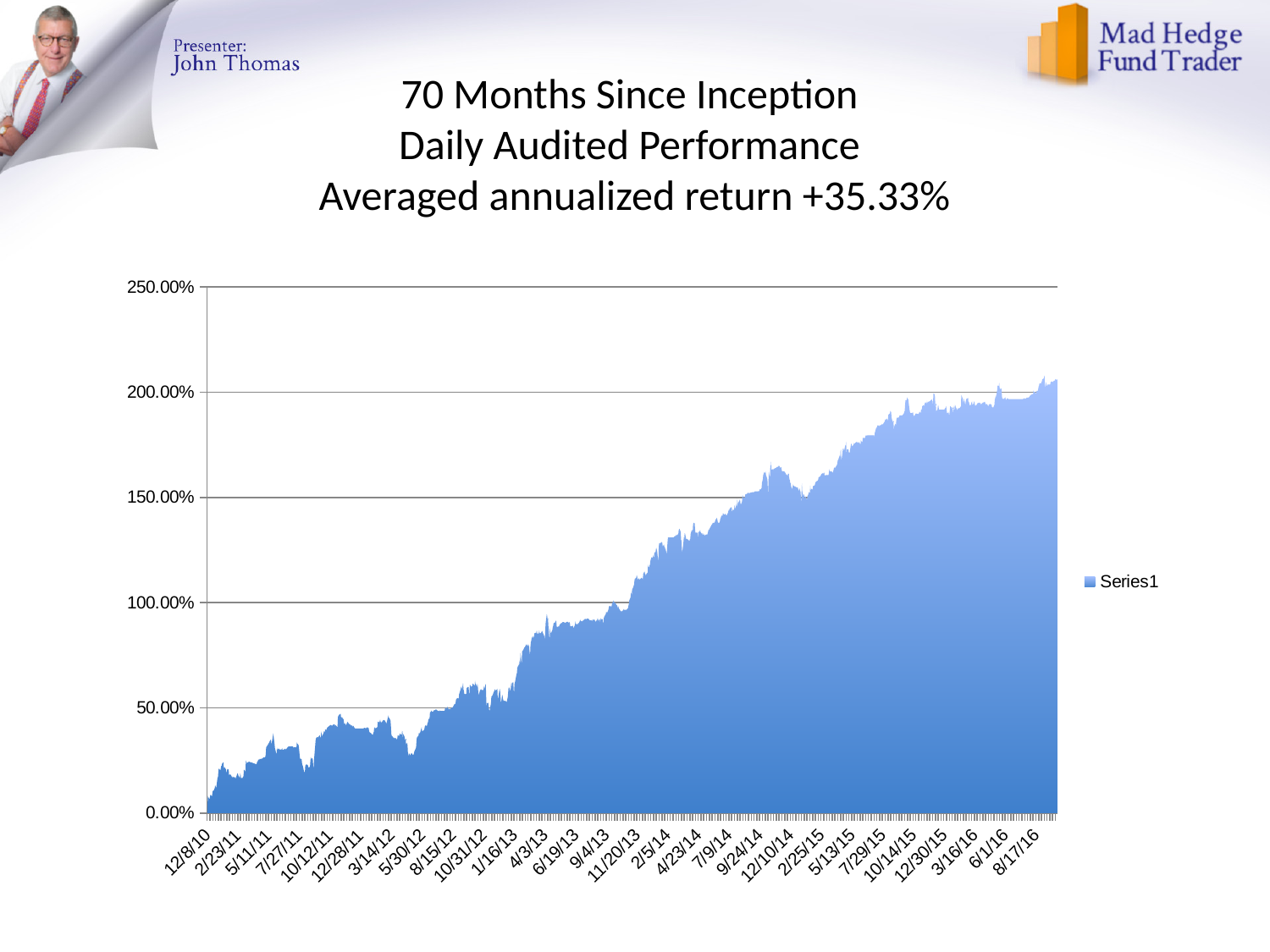
Is the value at 5/30/12 greater or less than 50%? less Which date has the larger value, 12/8/10 or 8/17/16? 8/17/16 What kind of chart is shown on the slide? area chart How many series does the legend list? 1 Do the values generally rise or fall from 12/8/10 to 8/17/16? rise What is the highest value shown on the vertical axis? 250.00% Is the value at 12/8/10 greater or less than 50%? less What is the name of the series shown in the legend? Series1 Which date has the larger value, 5/30/12 or 4/23/14? 4/23/14 Is the value at 8/17/16 greater or less than 150%? greater